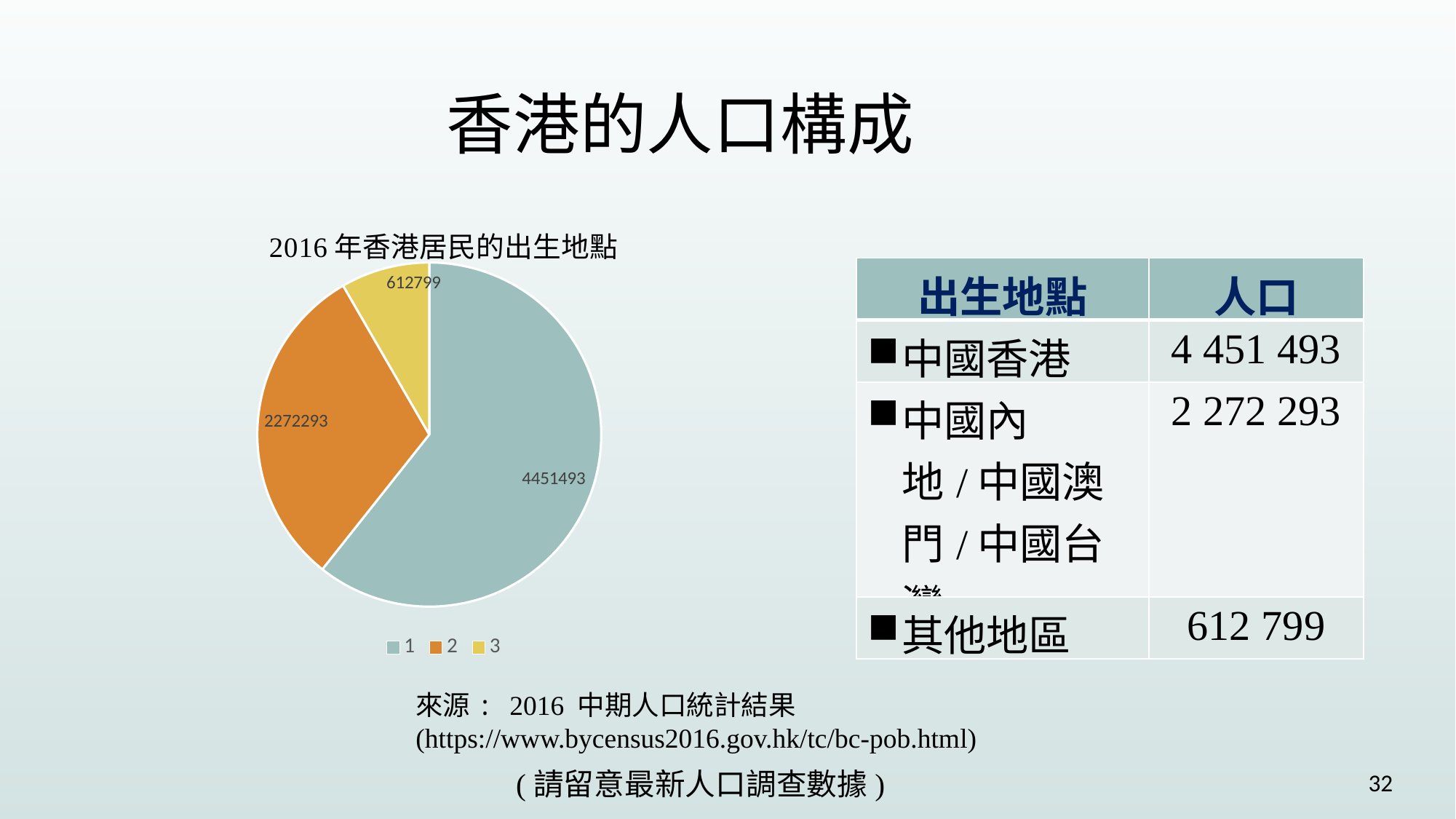
What is the title of the pie chart? 2016 年香港居民的出生地點 What is the total of all three slice values in the pie chart? 7336585 How many entries does the pie chart's legend list? 3 What is the value of slice 3 in the pie chart? 612799 What is the value of slice 1 in the pie chart? 4451493 Which slice of the pie chart is the smallest? 3 Which is larger in the pie chart, slice 2 or slice 3? slice 2 How many slices does the pie chart have? 3 What is the difference between the values of slice 1 and slice 2 in the pie chart? 2179200 Which slice of the pie chart is the largest? 1 What type of chart is shown on the slide? pie chart What is the value of slice 2 in the pie chart? 2272293